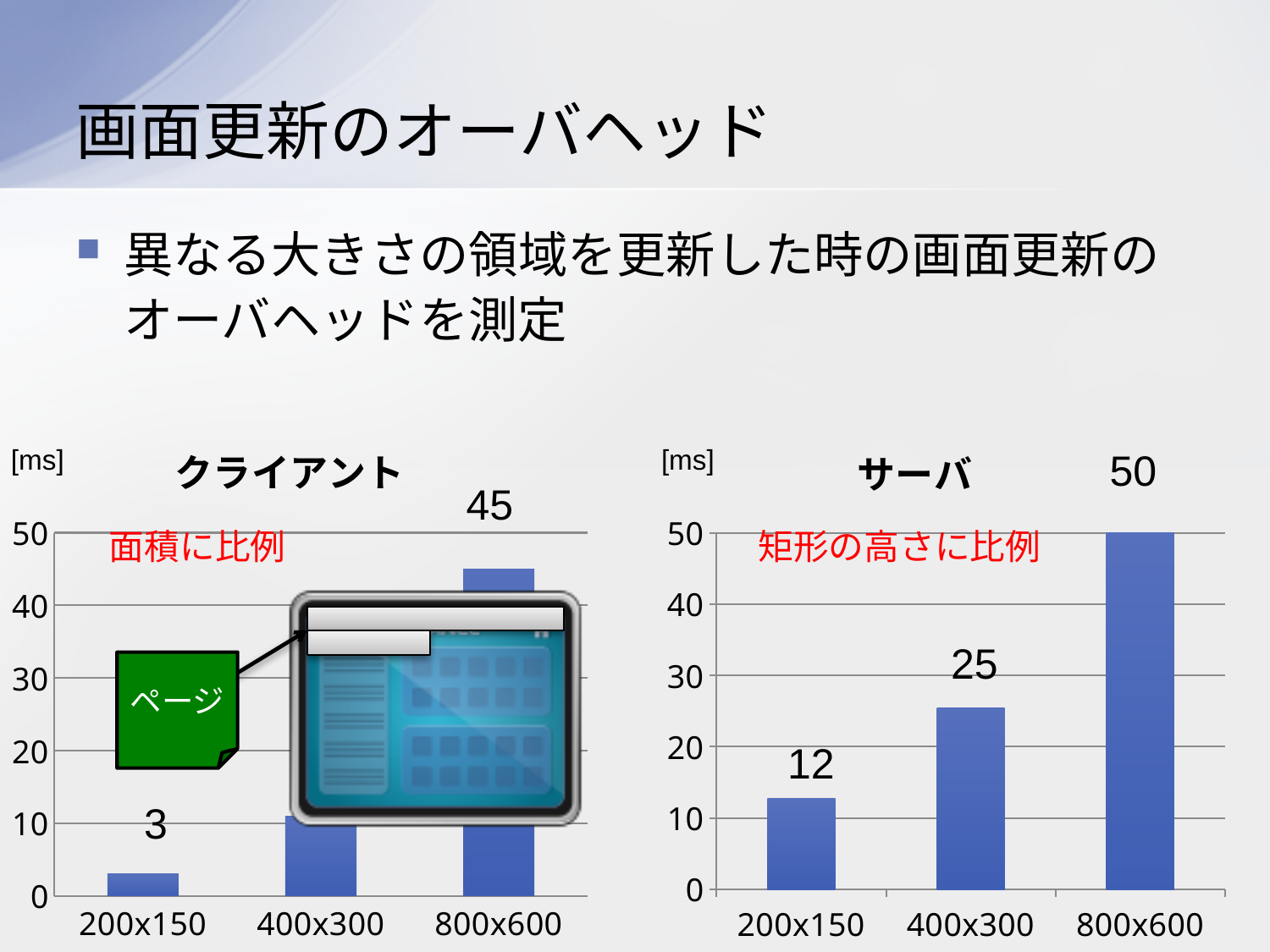
In the クライアント chart, what is the difference between the values for 800x600 and 200x150? 42 How many categories does the サーバ chart show? 3 What kind of chart is the サーバ chart? bar chart In the クライアント chart, what is the value for 200x150? 3 In the サーバ chart, what is the difference between the values for 800x600 and 200x150? 38 In the クライアント chart, what is the value for 800x600? 45 In the サーバ chart, what is the value for 400x300? 25 In the サーバ chart, which category has the highest value? 800x600 In the サーバ chart, what is the value for 800x600? 50 In the サーバ chart, what is the value for 200x150? 12 In the クライアント chart, which category has the lowest value? 200x150